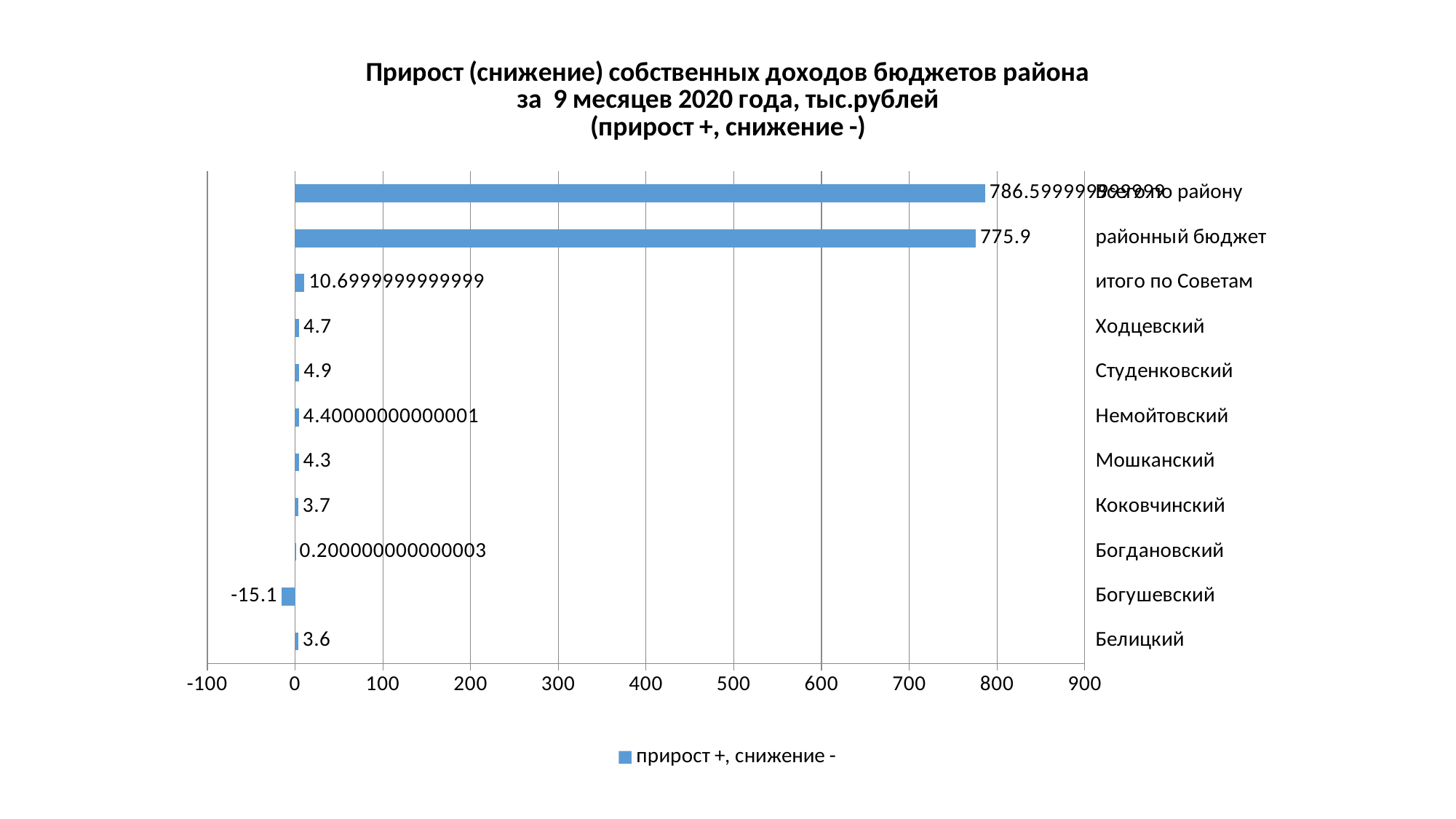
What is the value for Белицкий? 3.6 What is the difference between the values for Мошканский and Коковчинский? 0.6 What is the value for Студенковский? 4.9 What is the legend entry shown below the chart? прирост +, снижение - Which category has the highest value? Всего по району What is the value for районный бюджет? 775.9 What is the value for Богушевский? -15.1 What kind of chart is shown on the slide? bar chart How many categories are shown on the chart? 11 Which category has the lowest value? Богушевский What is the value for Ходцевский? 4.7 Which is larger, the value for Студенковский or the value for Ходцевский? Студенковский